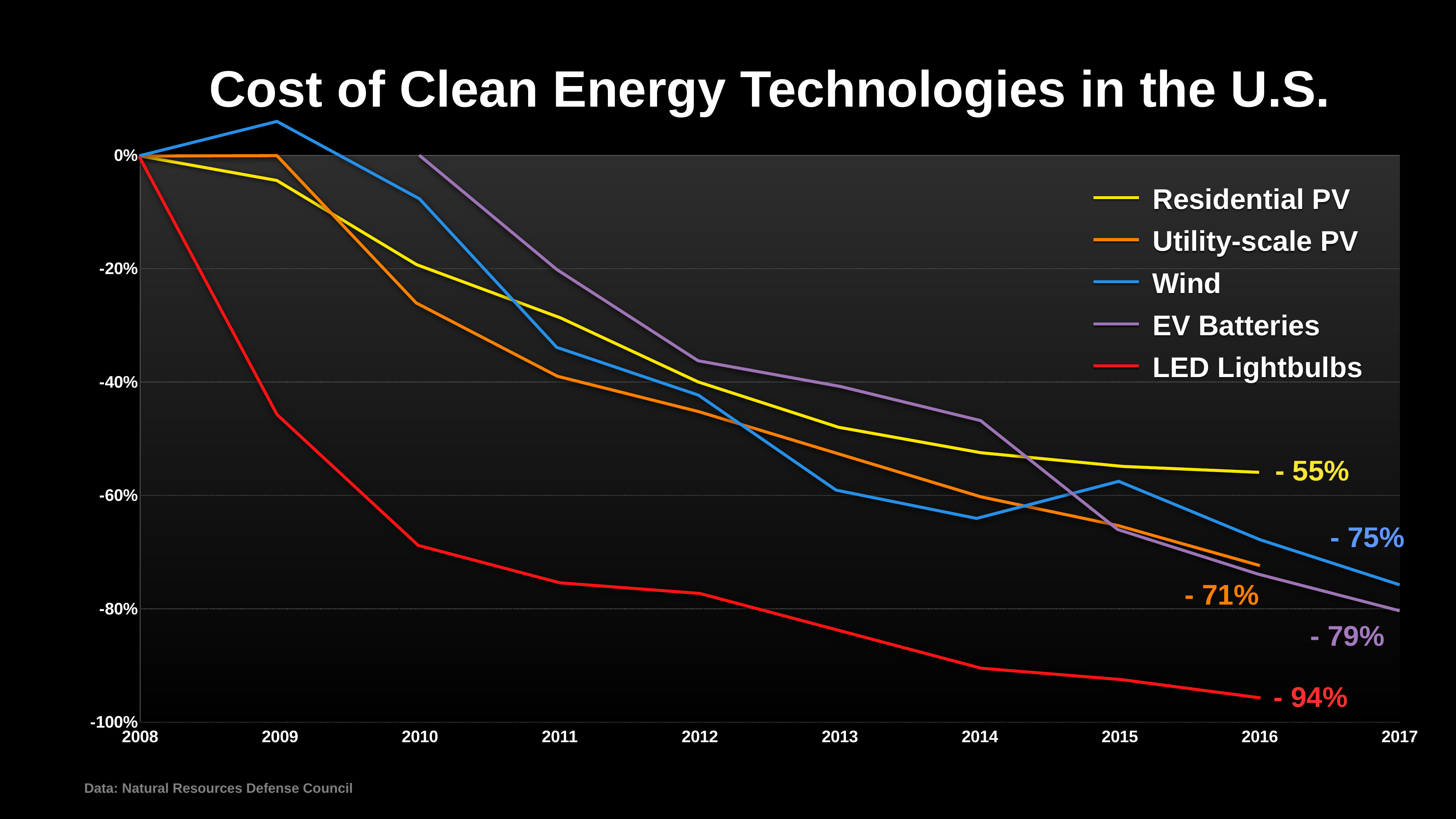
What is the labelled final value for Wind? - 75% Which technology shows the largest cost decline by the end of the chart? LED Lightbulbs How many series does the legend list? 5 What is the labelled final value for EV Batteries? - 79% What is the labelled final value for Residential PV? - 55% What is the labelled final value for LED Lightbulbs? - 94% Is the value for LED Lightbulbs in 2010 greater or less than -60%? less What is the labelled final value for Utility-scale PV? - 71% What kind of chart is shown on the slide? line chart Which technology shows the smallest cost decline by the end of the chart? Residential PV By how many percentage points does the final decline for LED Lightbulbs exceed that of Residential PV? 39 percentage points How many years are shown on the x axis? 10